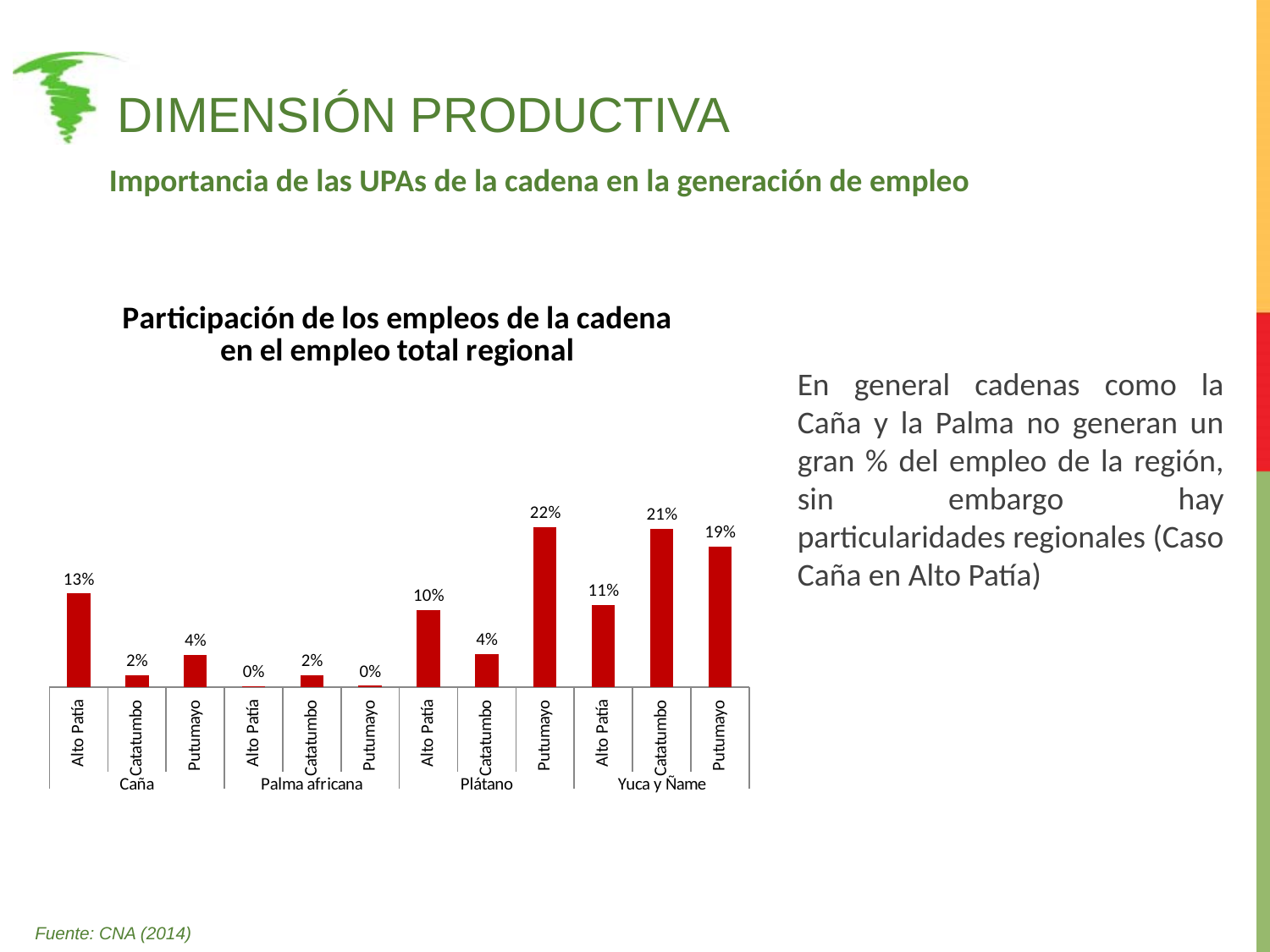
Within the Caña group, which region has the lowest value? Catatumbo Which bar has the highest value in the chart? Putumayo (Plátano) What is the value for Alto Patía in the Caña group? 13% What is the value for Alto Patía in the Palma africana group? 0% What is the title of the chart? Participación de los empleos de la cadena en el empleo total regional What kind of chart is shown on the slide? Bar chart Which is larger: Alto Patía in the Plátano group or Alto Patía in the Yuca y Ñame group? Alto Patía in the Yuca y Ñame group What is the value for Putumayo in the Plátano group? 22% What is the value for Catatumbo in the Yuca y Ñame group? 21% How many bars are plotted in the chart? 12 What is the difference between Putumayo in the Plátano group and Putumayo in the Yuca y Ñame group? 3% How many product groups are shown on the x axis? 4